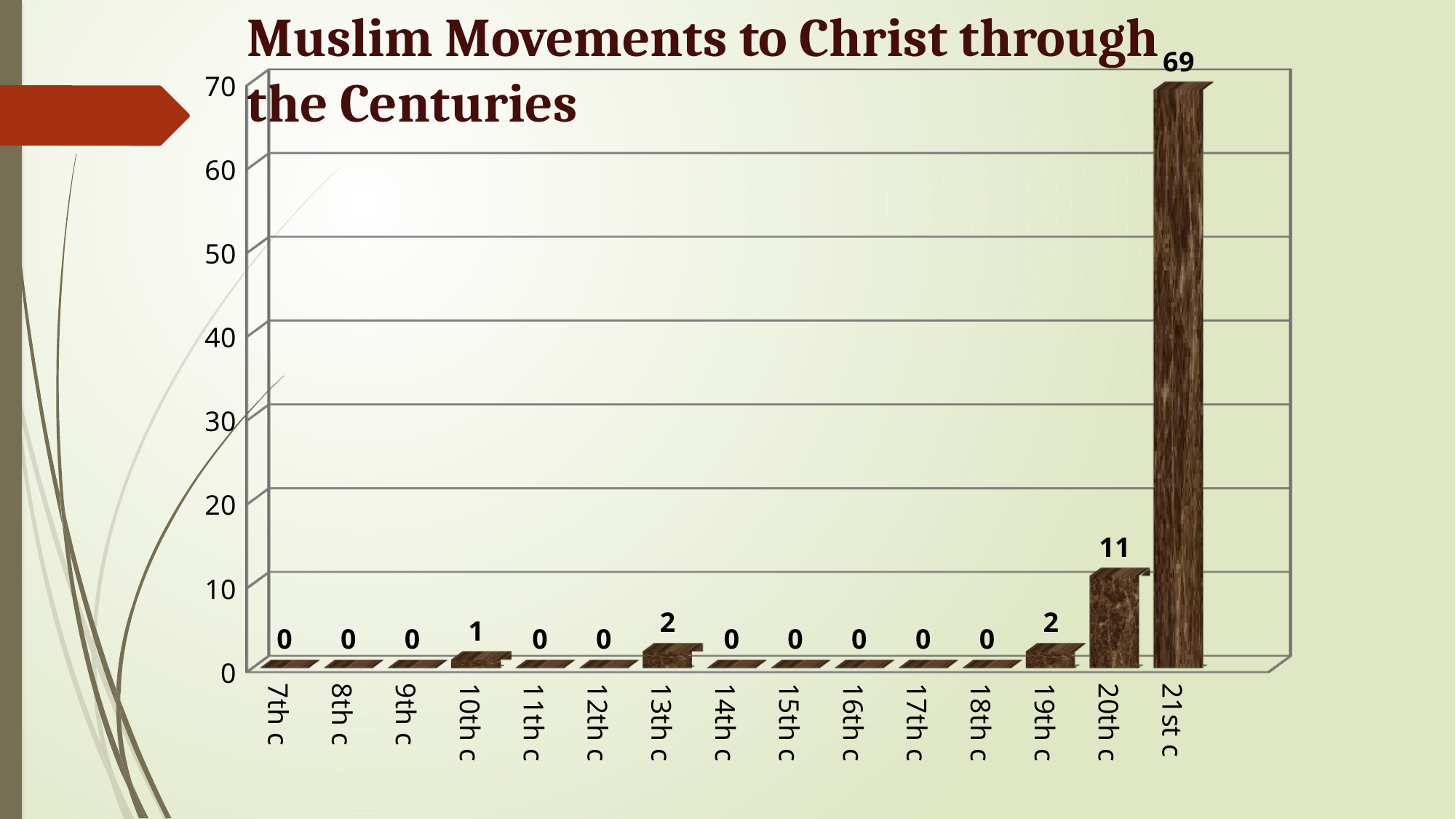
How many centuries are shown on the x axis? 15 What is the value for the 20th century? 11 What is the value for the 21st century? 69 What is the difference between the values for the 21st century and the 20th century? 58 Which is larger, the value for the 19th century or the 20th century? 20th c Is the value for the 21st century greater or less than 60? greater What is the title of the chart? Muslim Movements to Christ through the Centuries Which century has the highest value? 21st c What is the value for the 10th century? 1 What kind of chart is shown on the slide? bar chart What is the value for the 13th century? 2 How many centuries have a value of 0? 10